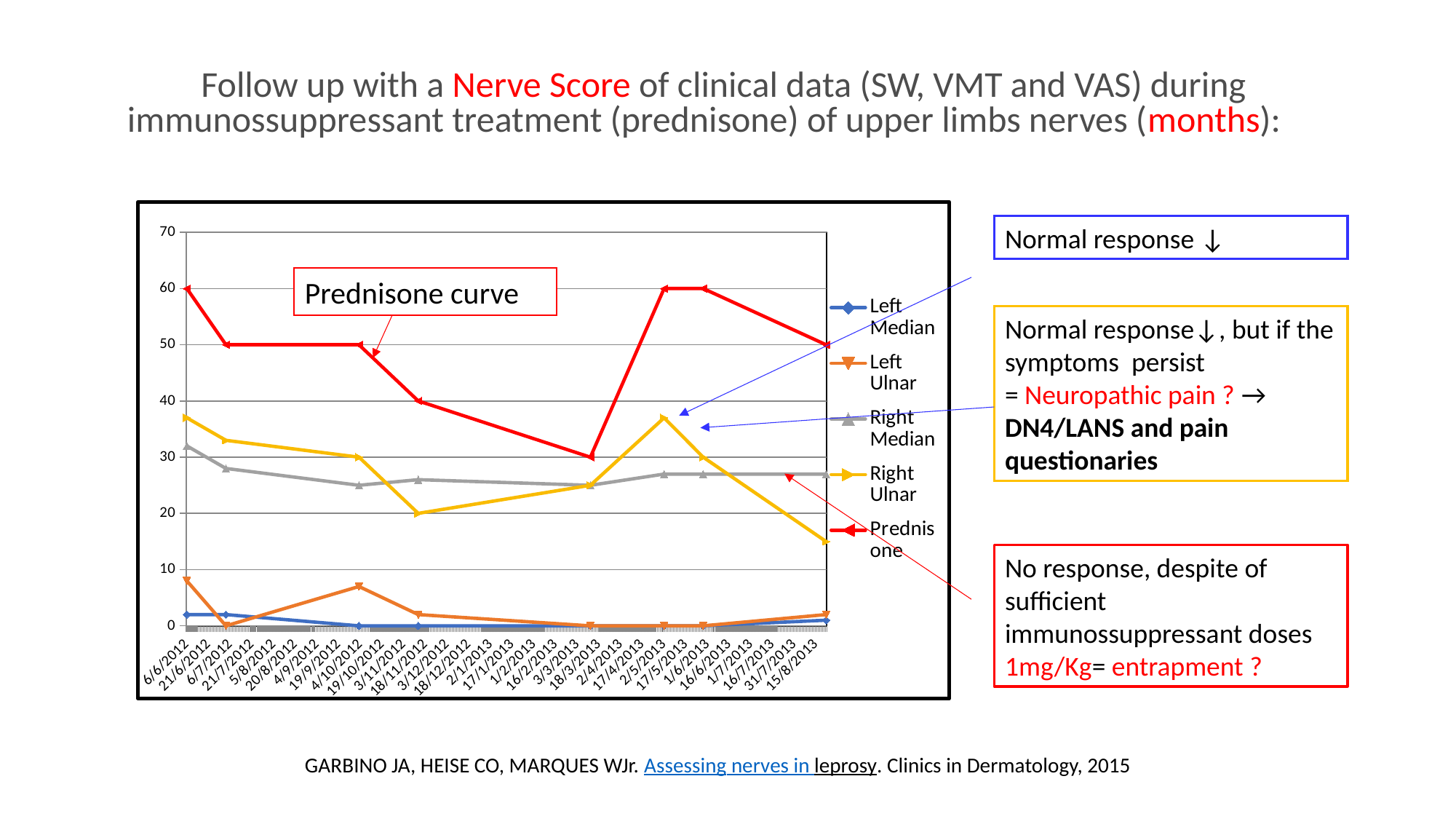
What is the value of the Prednisone line at 15/8/2013? 50 What is the value of the Right Ulnar line at 4/10/2012? 30 What colour is the Prednisone line in the chart? red At 6/6/2012, which is larger: Left Ulnar or Left Median? Left Ulnar Which series has the highest values across the chart? Prednisone Is the value for Right Median at 6/6/2012 greater or less than 30? greater Does the Right Ulnar line rise or fall overall from 6/6/2012 to 15/8/2013? fall How many series does the chart legend list? 5 What is the value of the Prednisone line at 6/6/2012? 60 What kind of chart is shown on the slide? line chart Is the value for Right Ulnar at 15/8/2013 greater or less than 20? less What is the lowest value the Prednisone line drops to? 30